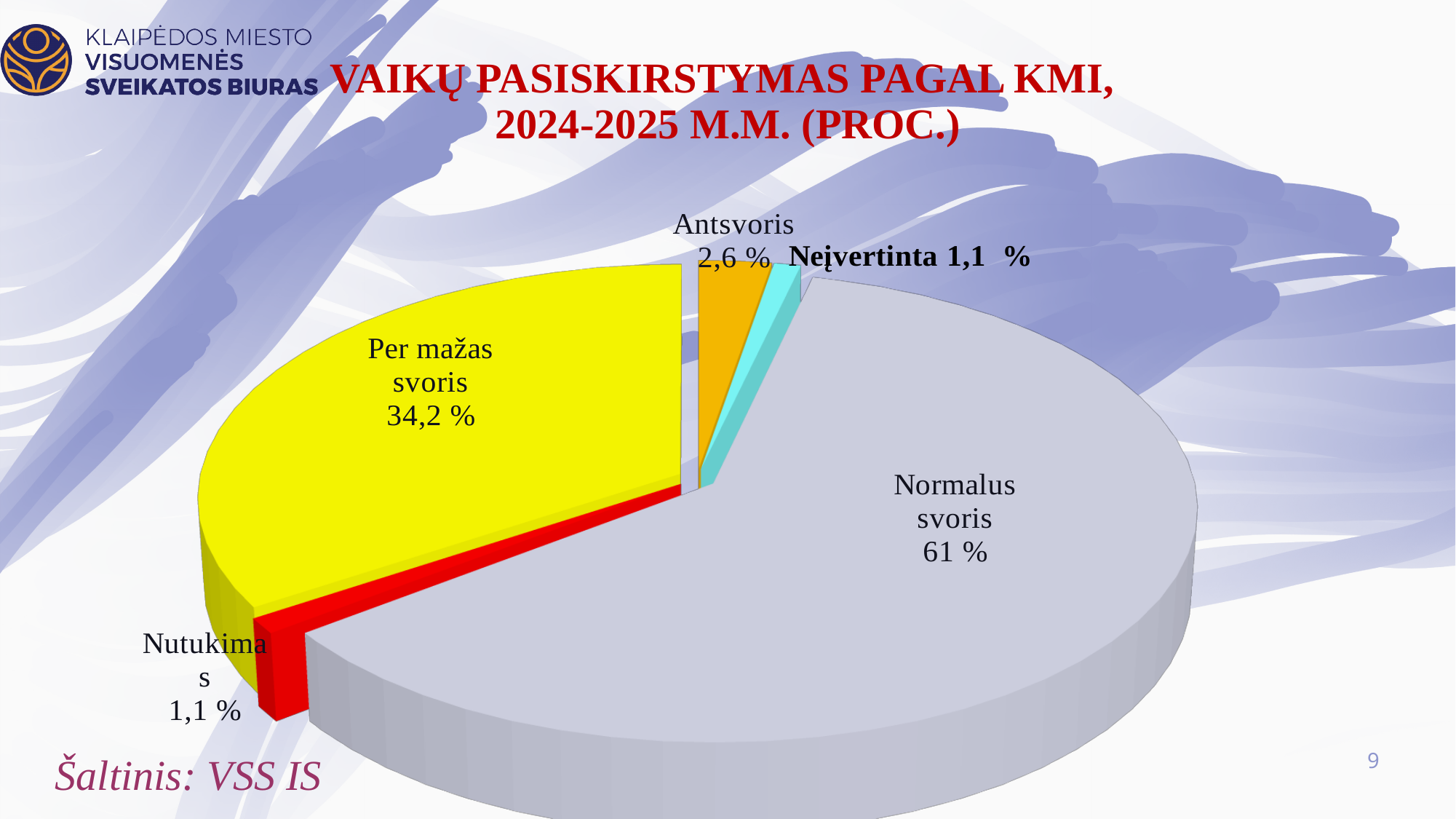
What is the value for Antsvoris? 2,6 % What is the value for Nutukimas? 1,1 % What is the value for Normalus svoris? 61 % What is the value for Neįvertinta? 1,1 % What is the difference between the values for Normalus svoris and Per mažas svoris? 26,8 % What is the difference between the values for Per mažas svoris and Antsvoris? 31,6 % What is the title of the chart? VAIKŲ PASISKIRSTYMAS PAGAL KMI, 2024-2025 M.M. (PROC.) What kind of chart is shown on the slide? Pie chart What is the value for Per mažas svoris? 34,2 % Which is larger, the value for Per mažas svoris or the value for Antsvoris? Per mažas svoris Which category has the largest share of the pie? Normalus svoris How many slices does the pie chart have? 5